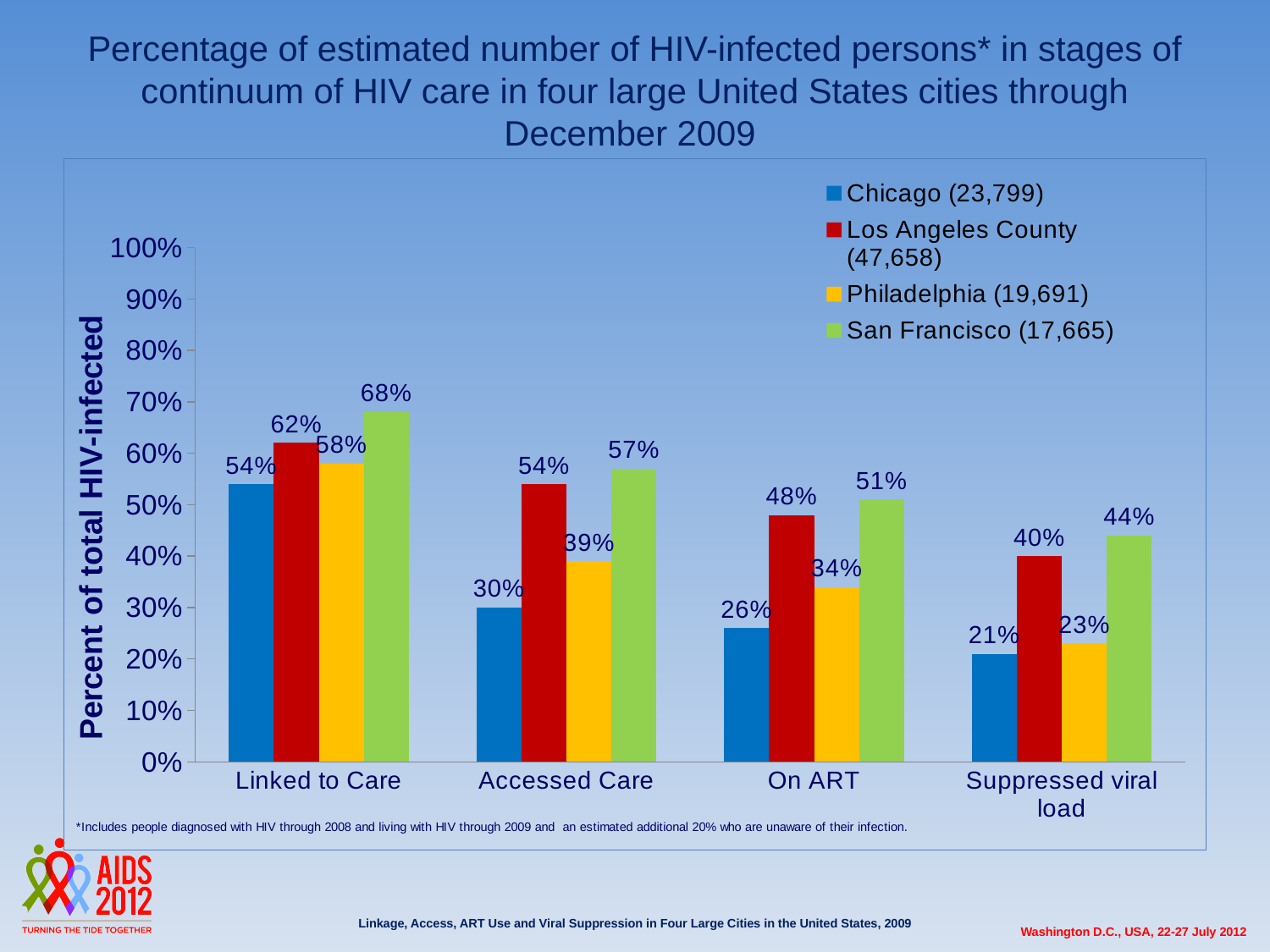
Which is larger: Los Angeles County's Accessed Care value or Philadelphia's Accessed Care value? Los Angeles County How many cities does the legend list? 4 Which city has the lowest value for On ART? Chicago Do the values for Chicago rise or fall from Linked to Care to Suppressed viral load? Fall What is the value for Los Angeles County in the Suppressed viral load category? 40% Which city has the highest value for Suppressed viral load? San Francisco What kind of chart is shown on the slide? Bar chart How many stages of the continuum of care are shown on the x axis? 4 What is the difference between San Francisco and Chicago in the Linked to Care category? 14% What percentage of HIV-infected persons in San Francisco were linked to care? 68% What is the value for Chicago in the Accessed Care category? 30% What percentage of HIV-infected persons in Philadelphia were on ART? 34%